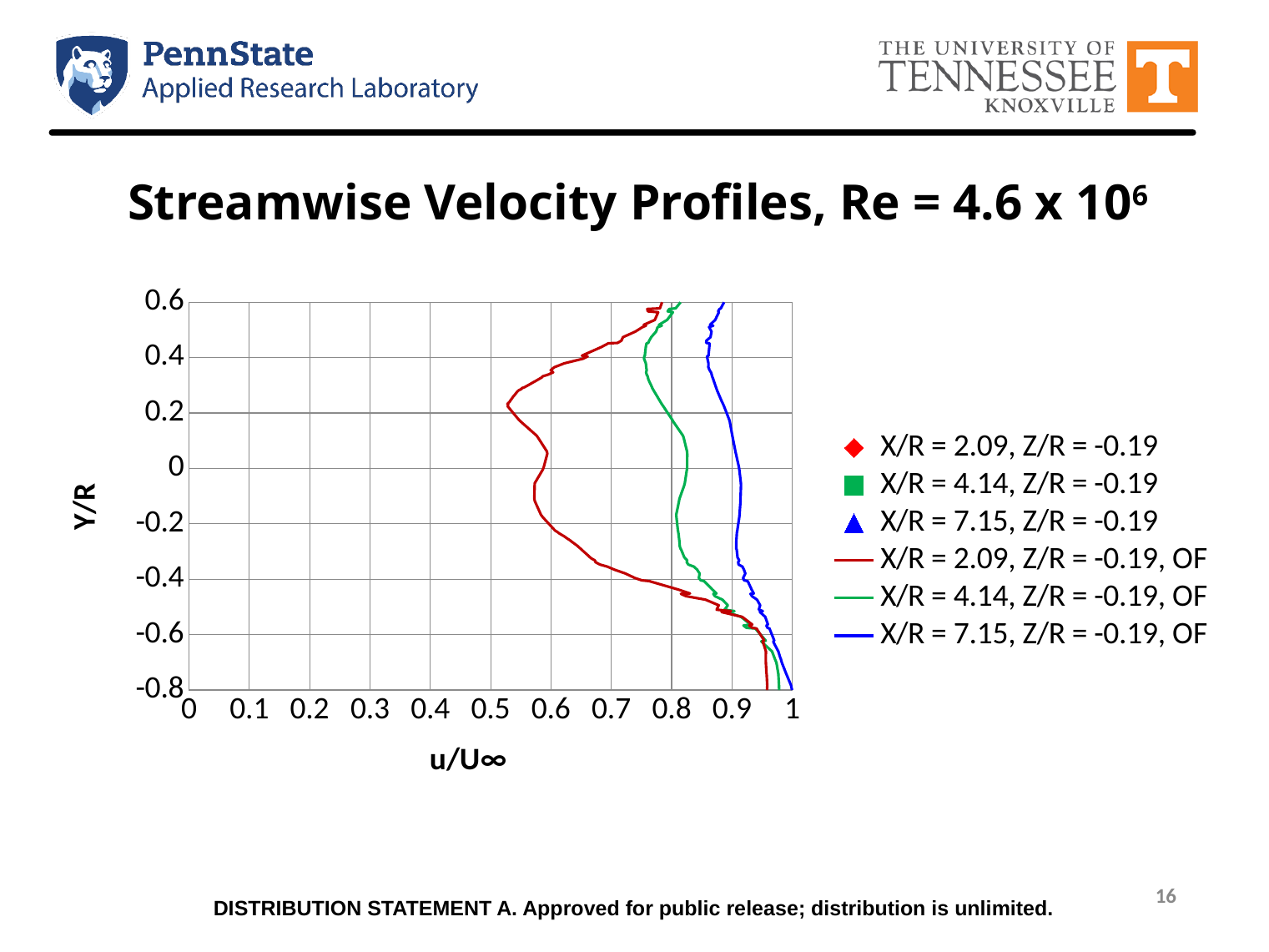
What is the title of the chart on the slide? Streamwise Velocity Profiles, Re = 4.6 x 10^6 Is the value of u/U∞ for the X/R = 7.15, Z/R = -0.19, OF curve at Y/R = -0.8 greater or less than 0.9? greater What is the label of the horizontal axis? u/U∞ How many series does the legend list? 6 At Y/R = 0.2, which OF curve has the lowest u/U∞? X/R = 2.09, Z/R = -0.19, OF What is the highest value shown on the Y/R axis? 0.6 At Y/R = 0, which curve has the larger u/U∞: X/R = 2.09, Z/R = -0.19, OF or X/R = 4.14, Z/R = -0.19, OF? X/R = 4.14, Z/R = -0.19, OF Is the value of u/U∞ for the X/R = 2.09, Z/R = -0.19, OF curve at Y/R = 0.2 greater or less than 0.6? less Is the value of u/U∞ for the X/R = 4.14, Z/R = -0.19, OF curve at Y/R = 0.4 greater or less than 0.8? less At Y/R = 0.2, which OF curve has the highest u/U∞? X/R = 7.15, Z/R = -0.19, OF What kind of chart is shown on the slide? line chart